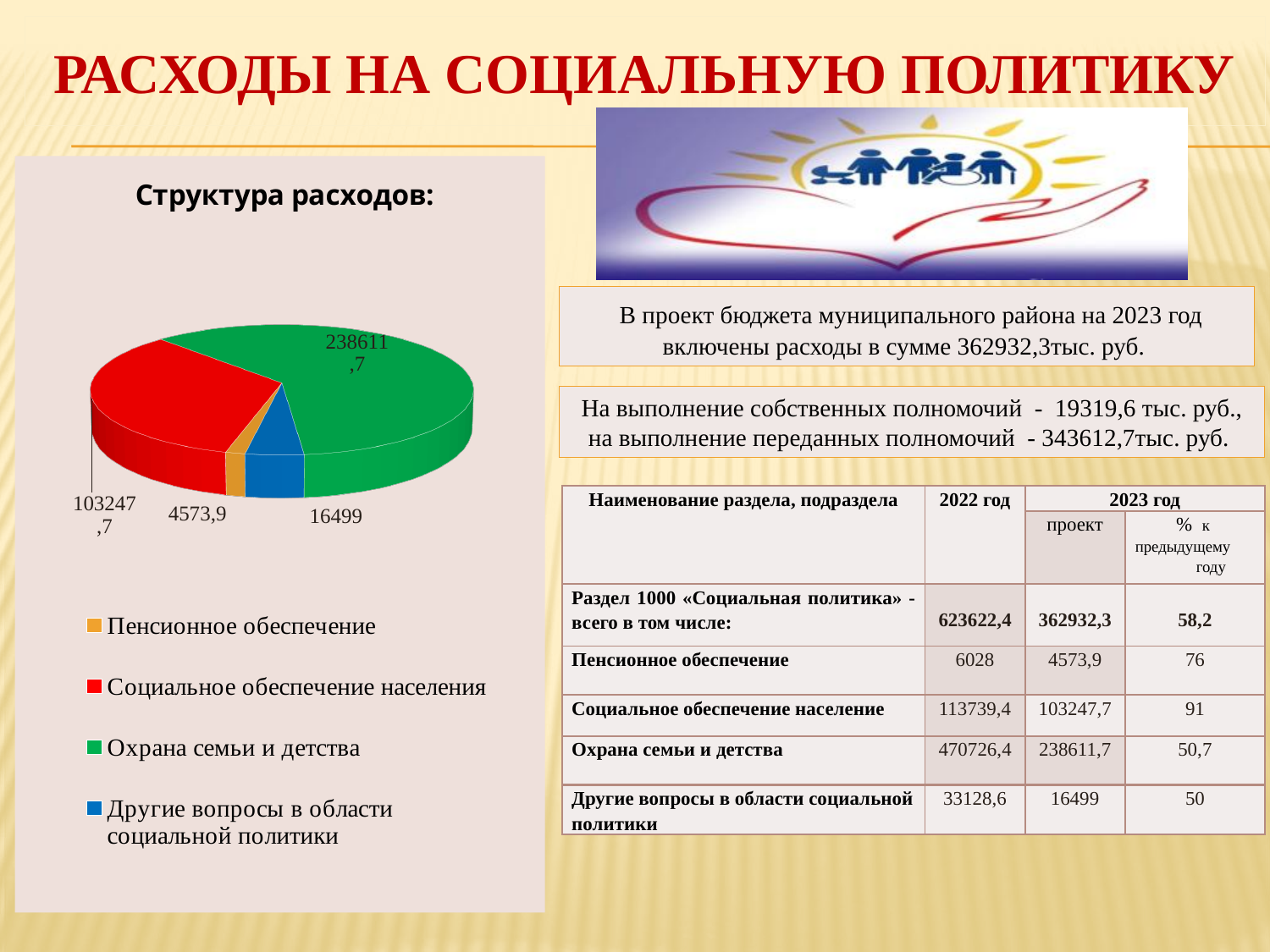
In the pie chart, what is the value for "Охрана семьи и детства"? 238611,7 What colour is the slice for "Охрана семьи и детства" in the pie chart? green In the pie chart, which is larger: "Социальное обеспечение населения" or "Другие вопросы в области социальной политики"? Социальное обеспечение населения What is the difference between the values for "Охрана семьи и детства" and "Социальное обеспечение населения" in the pie chart? 135364 How many slices does the pie chart have? 4 In the pie chart, what is the value for "Другие вопросы в области социальной политики"? 16499 What type of chart is shown under the heading "Структура расходов:"? pie chart How many entries does the pie chart's legend list? 4 In the pie chart, what is the value for "Социальное обеспечение населения"? 103247,7 In the pie chart, what is the value for "Пенсионное обеспечение"? 4573,9 Which category has the smallest slice in the pie chart? Пенсионное обеспечение Which category has the largest slice in the pie chart? Охрана семьи и детства